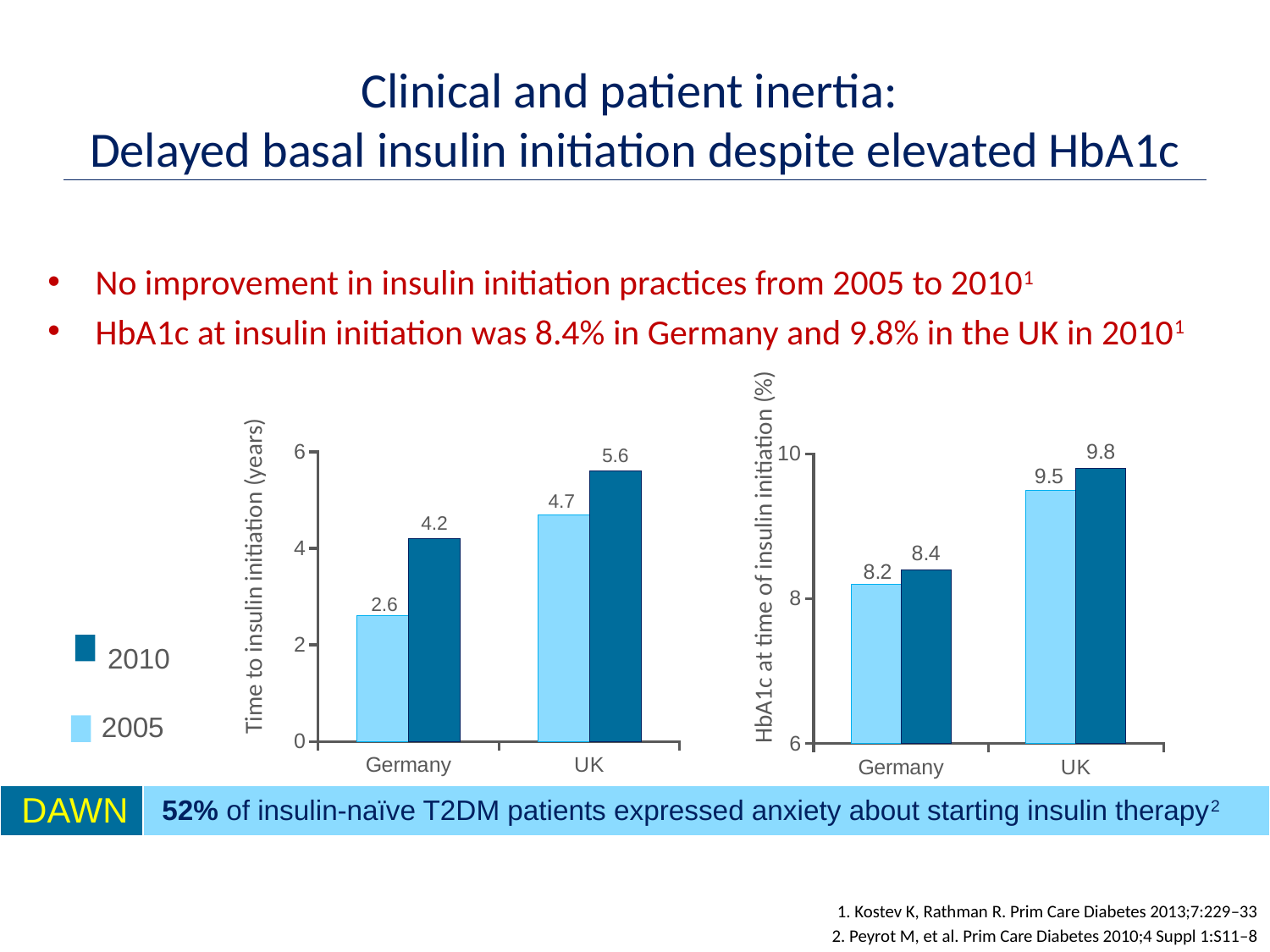
In the left chart (time to insulin initiation), what is the difference between the 2010 and 2005 values for Germany? 1.6 In the left chart (time to insulin initiation), what is the value for the UK in 2010? 5.6 In the left chart (time to insulin initiation), which is larger: the UK value in 2005 or the Germany value in 2010? UK 2005 In the right chart (HbA1c at time of insulin initiation), what is the difference between the UK and Germany values in 2010? 1.4 In the right chart (HbA1c at time of insulin initiation), what is the value for Germany in 2010? 8.4 In the left chart (time to insulin initiation), what is the value for Germany in 2005? 2.6 In the left chart (time to insulin initiation), which bar is the highest? UK 2010 In the right chart (HbA1c at time of insulin initiation), what is the value for the UK in 2005? 9.5 In the right chart (HbA1c at time of insulin initiation), which bar is the lowest? Germany 2005 Which colour represents 2010 in the legend? Dark blue How many series does the legend list? 2 What kind of chart is the right chart (HbA1c at time of insulin initiation)? Bar chart